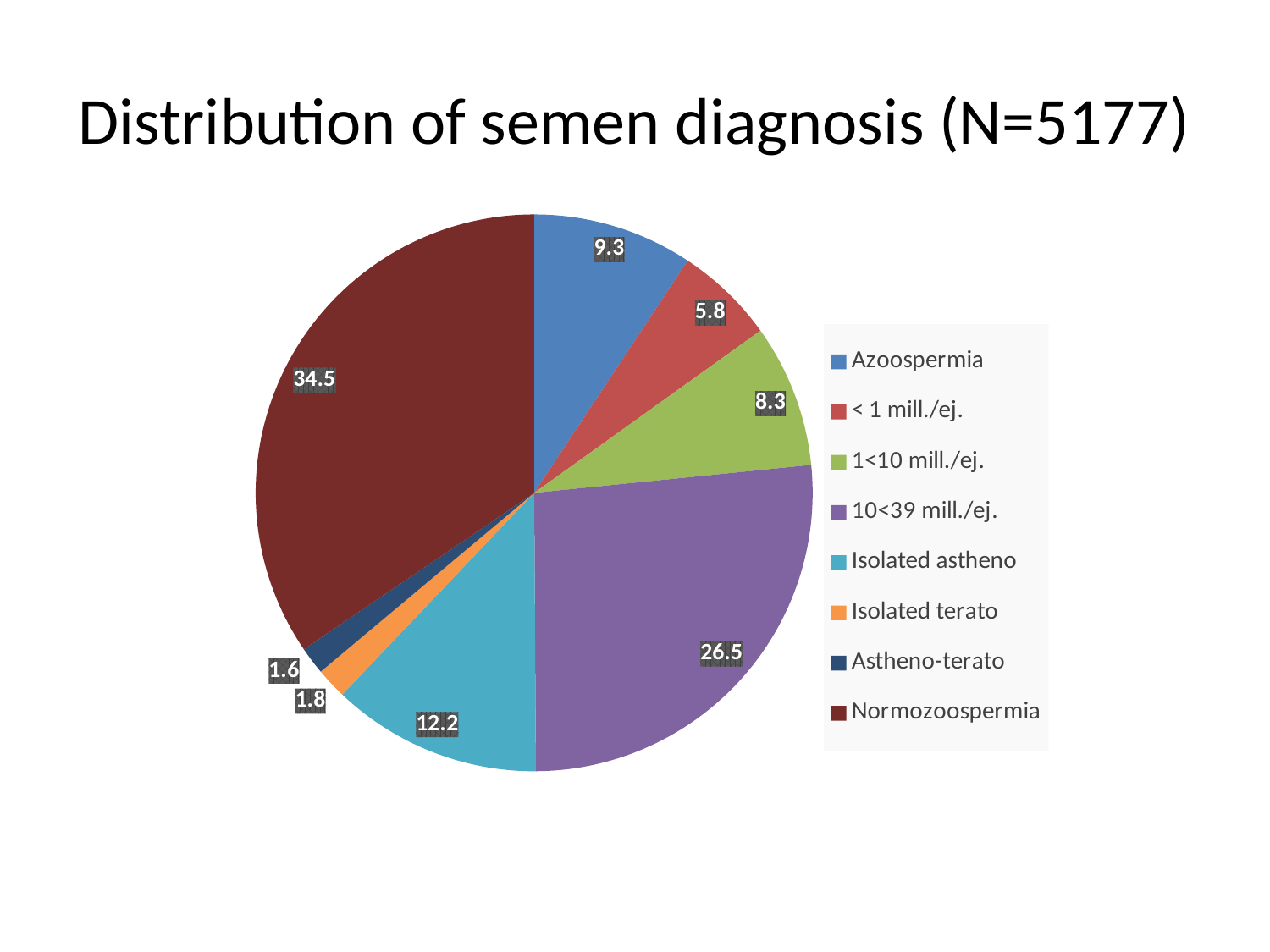
What is the difference between the values for Normozoospermia and 10<39 mill./ej.? 8.0 What is the value for Azoospermia? 9.3 Which is larger, the value for < 1 mill./ej. or the value for 1<10 mill./ej.? 1<10 mill./ej. What colour is the slice for Isolated astheno? teal What is the title of the chart? Distribution of semen diagnosis (N=5177) What type of chart is shown on the slide? pie chart What is the value for Normozoospermia? 34.5 What is the value for Isolated terato? 1.8 What is the value for Isolated astheno? 12.2 How many categories does the pie chart show? 8 What is the value for 10<39 mill./ej.? 26.5 Which category has the largest slice of the pie? Normozoospermia